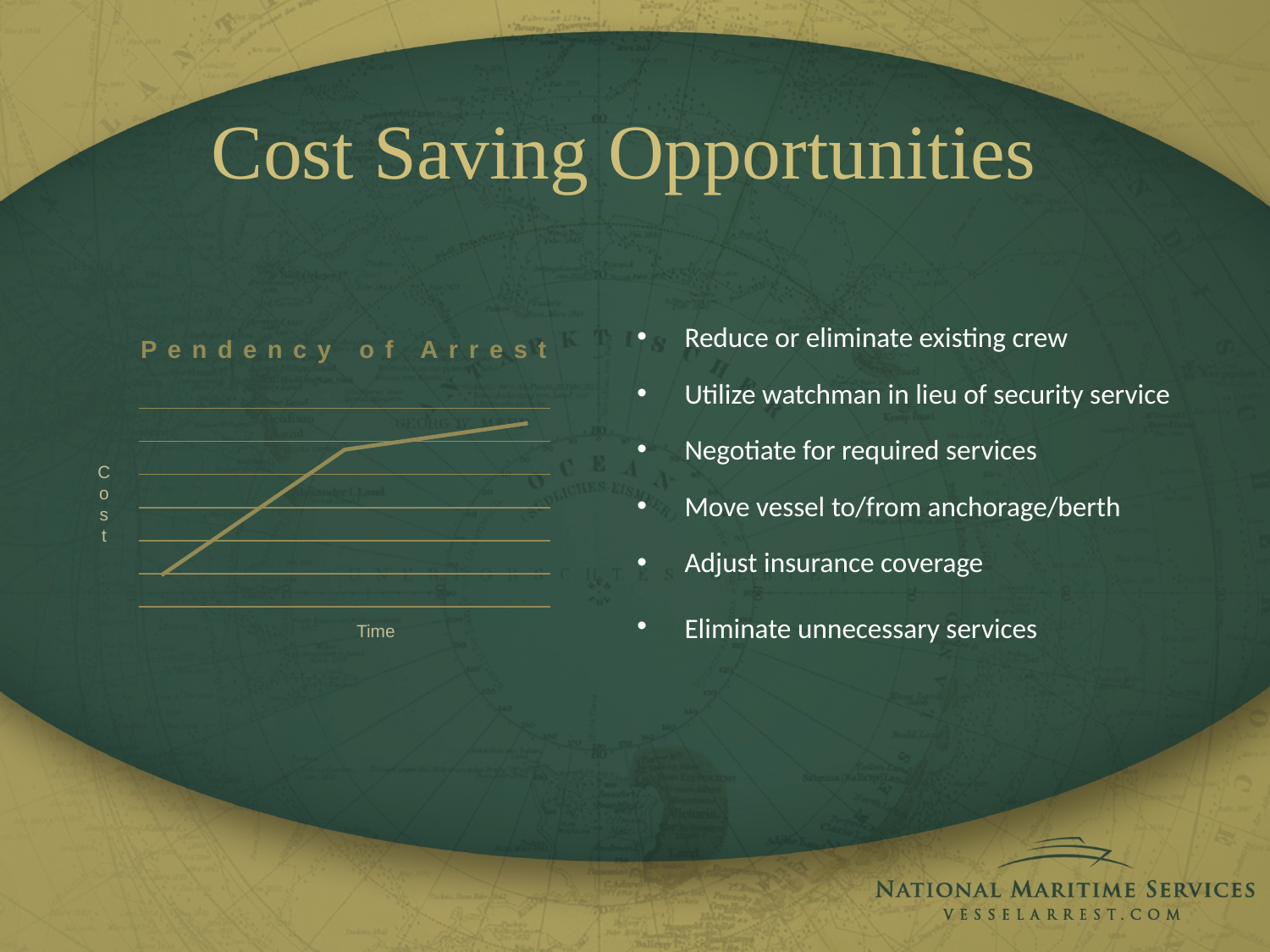
What kind of chart is the "Pendency of Arrest" chart? line chart What is the title of the chart on the slide? Pendency of Arrest What is the label of the x axis of the "Pendency of Arrest" chart? Time In the "Pendency of Arrest" chart, does the line rise or fall as time increases along the x axis? rise